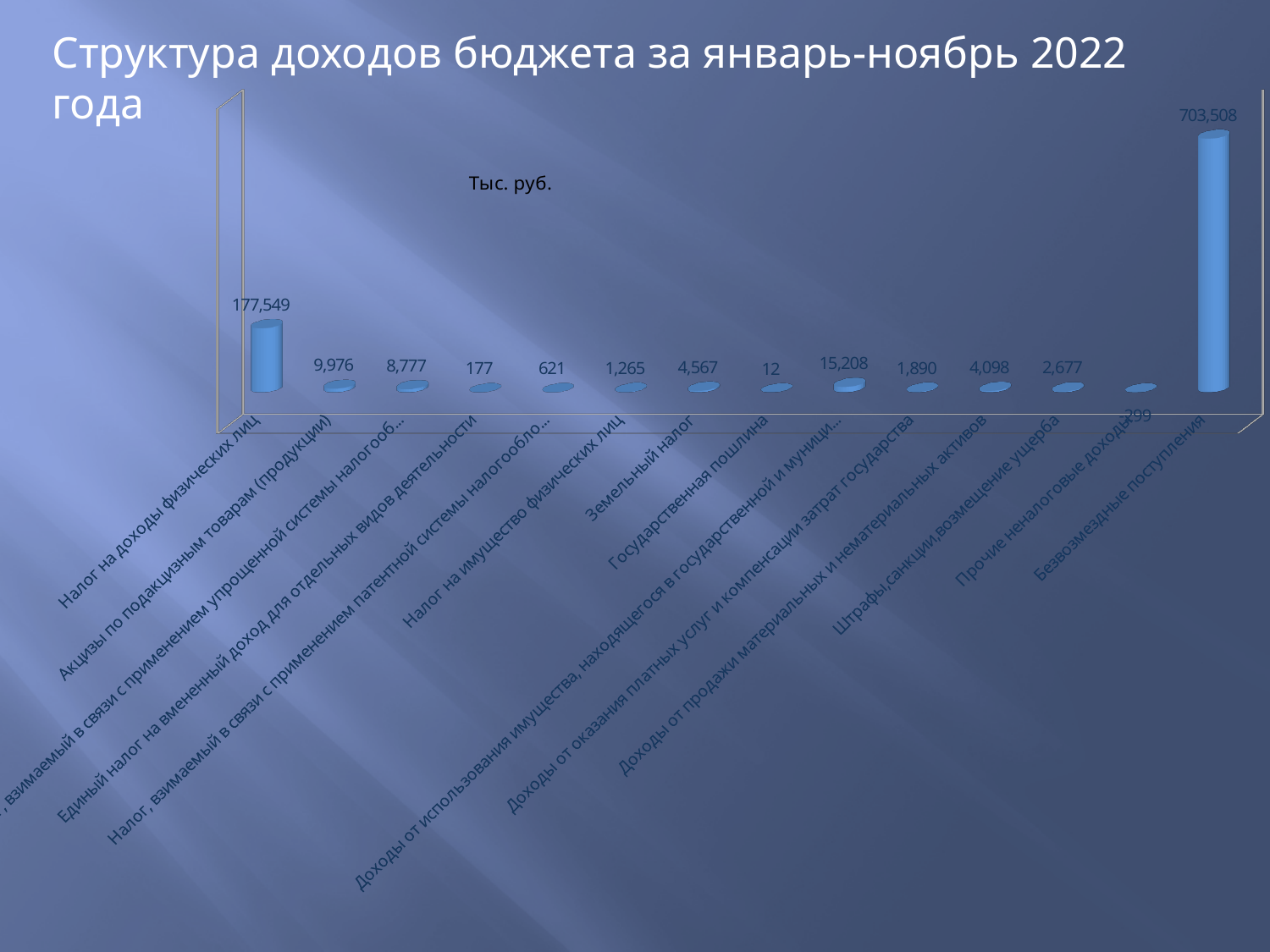
What is the difference between the values for Безвозмездные поступления and Налог на доходы физических лиц? 525,959 Which category has the lowest value? Прочие неналоговые доходы Which is larger: the value for Акцизы по подакцизным товарам (продукции) or the value for Налог на имущество физических лиц? Акцизы по подакцизным товарам (продукции) What is the value for Земельный налог? 4,567 What is the value for Государственная пошлина? 12 Which category has the highest value? Безвозмездные поступления What is the value for Налог на доходы физических лиц? 177,549 What is the value for Безвозмездные поступления? 703,508 What unit label is shown on the chart? Тыс. руб. What is the value for Штрафы,санкции,возмещение ущерба? 2,677 What type of chart is shown on the slide? Bar chart How many categories are plotted in the chart? 14